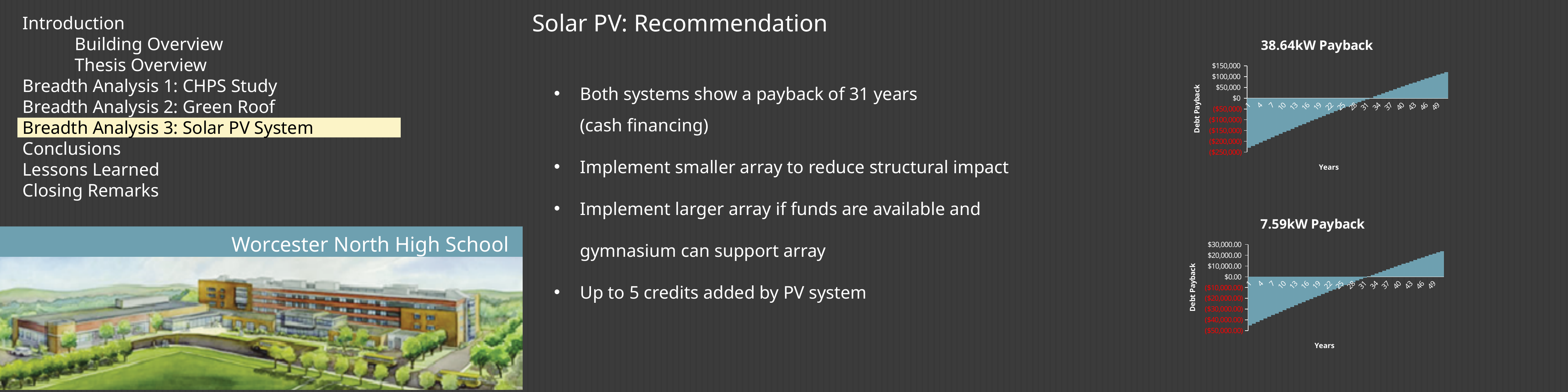
What is the highest y-axis tick label shown on the "7.59kW Payback" chart? $30,000.00 What is the last year label on the x axis of the "38.64kW Payback" chart? 49 In the "7.59kW Payback" chart, is the value at year 13 greater or less than $0.00? less In the "38.64kW Payback" chart, do the values rise or fall as the years increase? rise In the "38.64kW Payback" chart, is the value at year 43 greater or less than $0? greater In the "38.64kW Payback" chart, is the value at year 10 greater or less than $0? less What is the y-axis title of the "38.64kW Payback" chart? Debt Payback What is the x-axis title of the "7.59kW Payback" chart? Years What kind of chart is the "38.64kW Payback" chart? bar chart What kind of chart is the "7.59kW Payback" chart? bar chart In the "7.59kW Payback" chart, do the values rise or fall as the years increase? rise